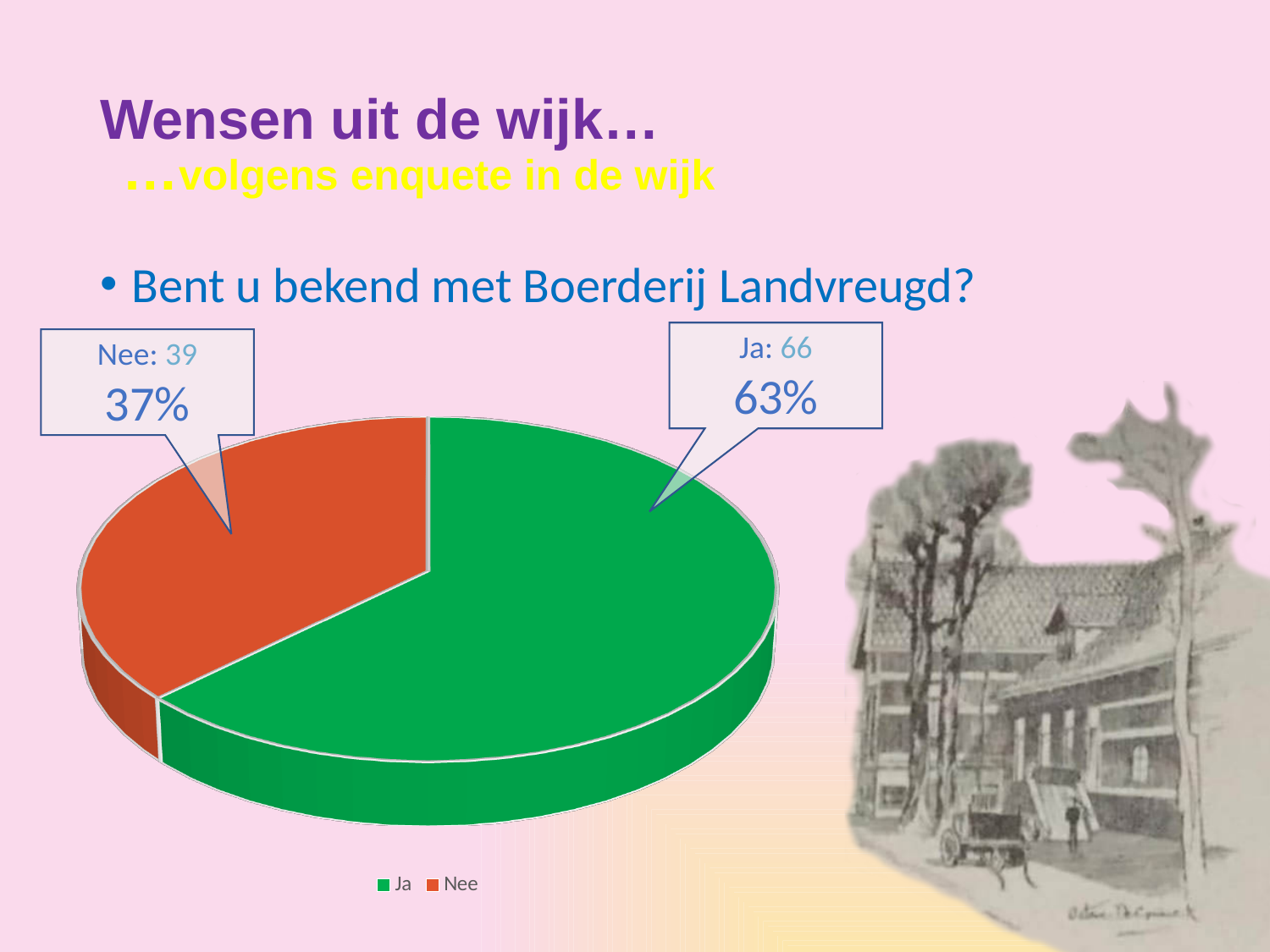
How many respondents answered "Nee"? 39 What is the difference between the number of "Ja" and "Nee" responses? 27 Which category has the smallest slice of the pie? Nee What kind of chart is shown on the slide? pie chart What percentage of the pie does the "Ja" slice represent? 63% Which category has the largest slice of the pie? Ja Which is larger, the "Ja" count or the "Nee" count? Ja How many respondents answered "Ja"? 66 What is the total number of responses shown in the pie chart? 105 What percentage of the pie does the "Nee" slice represent? 37% How many categories does the pie chart have? 2 What colour is the "Nee" slice in the pie chart? red